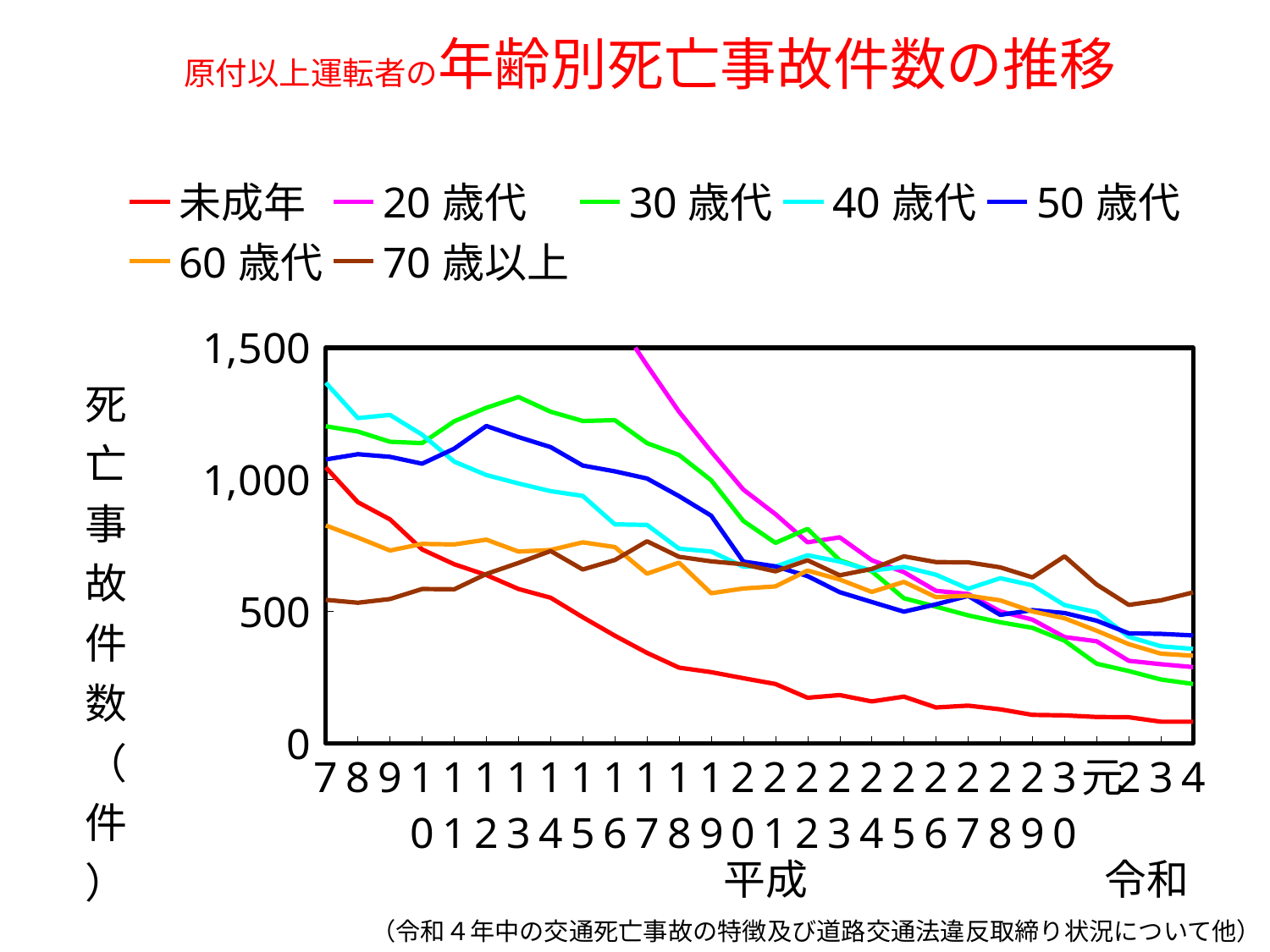
How many years (data points) are plotted along the x axis? 28 Is the value for 40歳代 in 平成7 greater or less than 1,000? greater Which series has the highest value in 令和4? 70歳以上 Is the value for 50歳代 in 令和4 greater or less than 500? less What kind of chart is shown on the slide? line chart Does the 未成年 line rise or fall from 平成7 to 令和4? fall Is the value for 未成年 in 令和4 greater or less than 500? less In 平成7, which is larger, the value for 40歳代 or the value for 60歳代? 40歳代 Does the 30歳代 line rise or fall from 平成13 to 令和4? fall How many series does the legend list? 7 Which series has the lowest value in 令和4? 未成年 In 令和4, which is larger, the value for 70歳以上 or the value for 未成年? 70歳以上